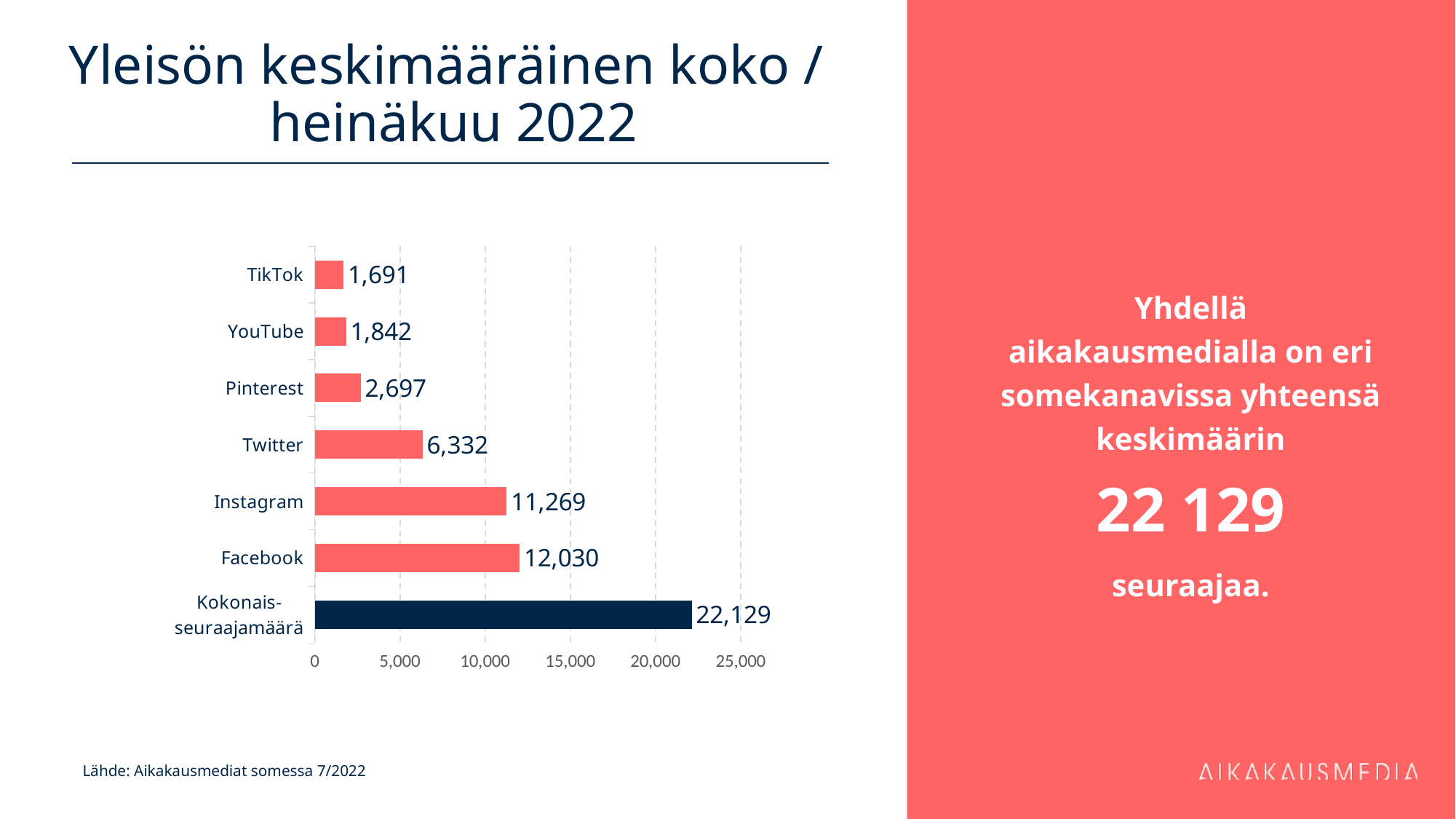
What is the value for Twitter? 6,332 What is the title of the chart on the slide? Yleisön keskimääräinen koko / heinäkuu 2022 Which category has the lowest value? TikTok Which is larger, the value for YouTube or the value for Pinterest? Pinterest Is the value for Instagram greater or less than 10,000? greater What is the difference between the values for YouTube and TikTok? 151 What is the difference between the values for Facebook and Instagram? 761 How many categories are shown in the chart? 7 Which individual social media channel has the highest value? Facebook What is the value for Kokonais-seuraajamäärä? 22,129 What is the value for Facebook? 12,030 What kind of chart is shown on the slide? bar chart